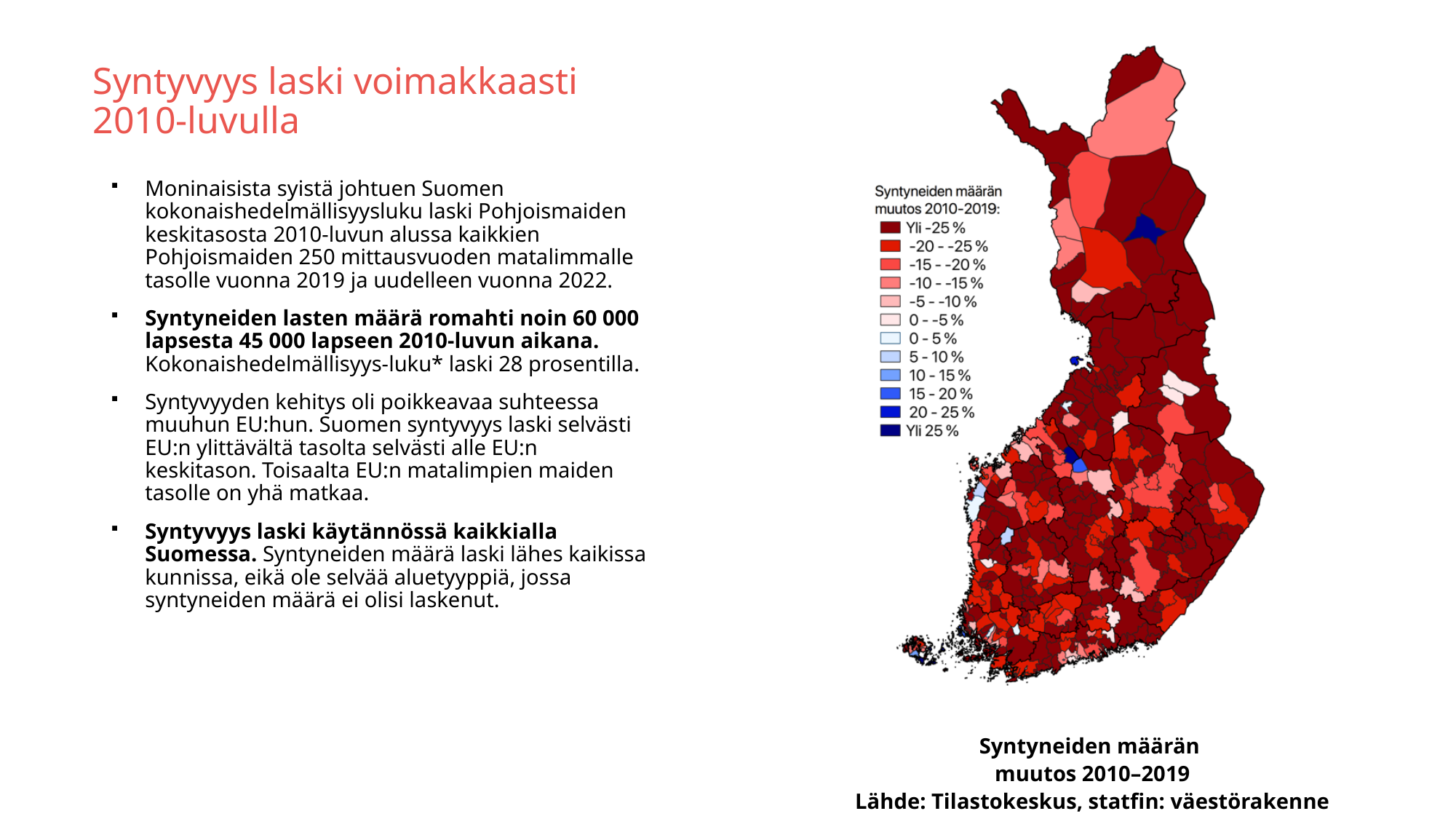
What is the source given for the map? Tilastokeskus, statfin: väestörakenne Which legend class is shown in the darkest blue colour on the map? Yli 25 % What period does the map's change in number of births cover? 2010–2019 What kind of chart is shown on the right side of the slide? A map (choropleth map of Finland) Which colour family, red or blue, covers most of the municipalities on the map? Red Which legend class covers the range from -20 % to -25 %? -20 - -25 % What is the title of the map according to its legend heading? Syntyneiden määrän muutos 2010-2019 How many colour classes does the map legend list? 12 Which legend class is shown in the darkest red colour on the map? Yli -25 %